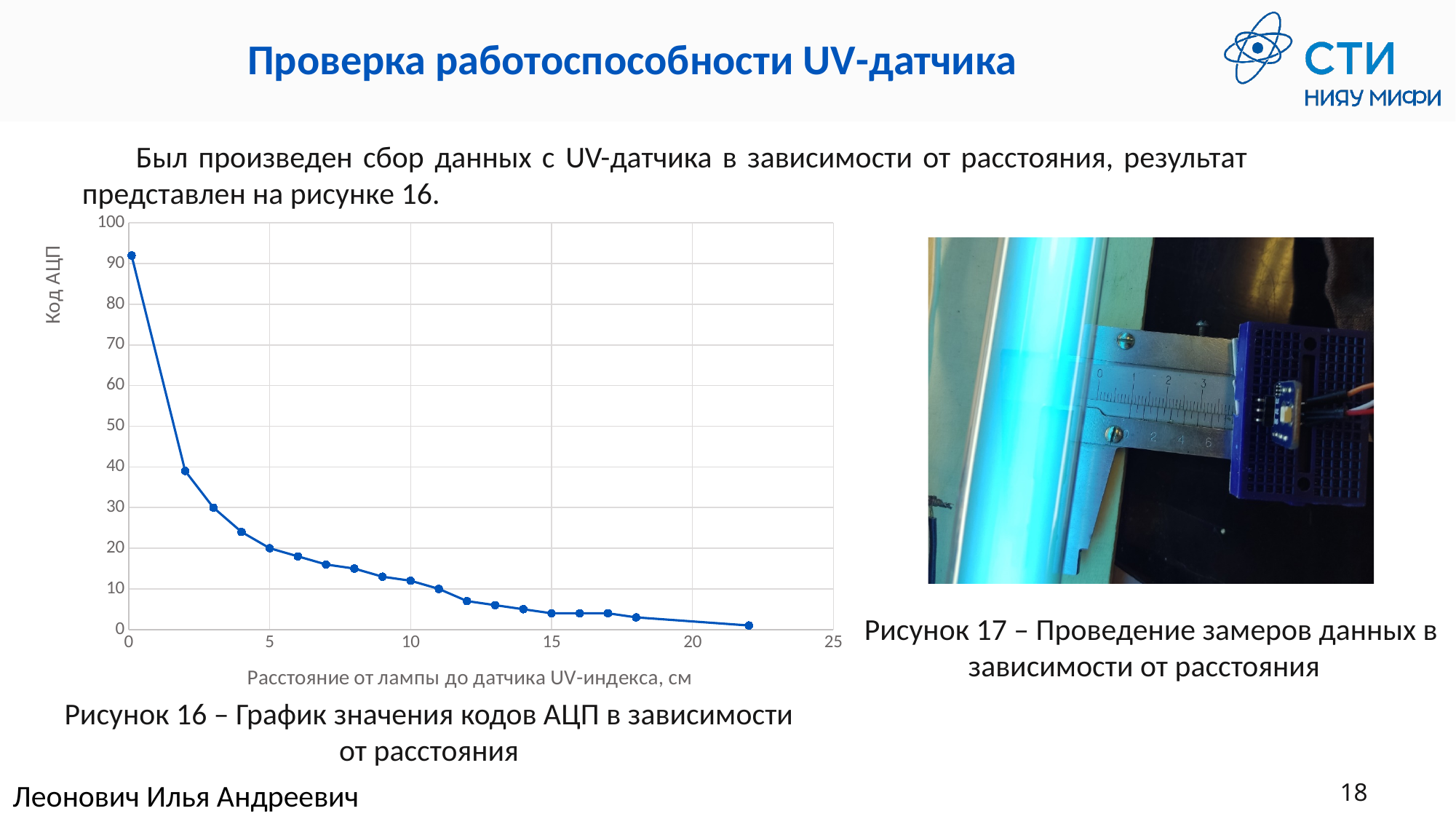
Is the ADC code value at a distance of 12 cm greater or less than 10? less What is the title of the x axis of the chart? Расстояние от лампы до датчика UV-индекса, см Is the ADC code value at a distance of 0 cm greater or less than 90? greater What is the title of the y axis of the chart? Код АЦП What kind of chart is shown in Figure 16? line chart Is the ADC code value at a distance of 4 cm greater or less than 20? greater In the chart, do the ADC code values rise or fall as the distance from the lamp increases? fall Which has a larger ADC code value: the point at 2 cm or the point at 3 cm? 2 cm At which distance is the ADC code value highest? 0 cm How many data points are plotted on the chart? 19